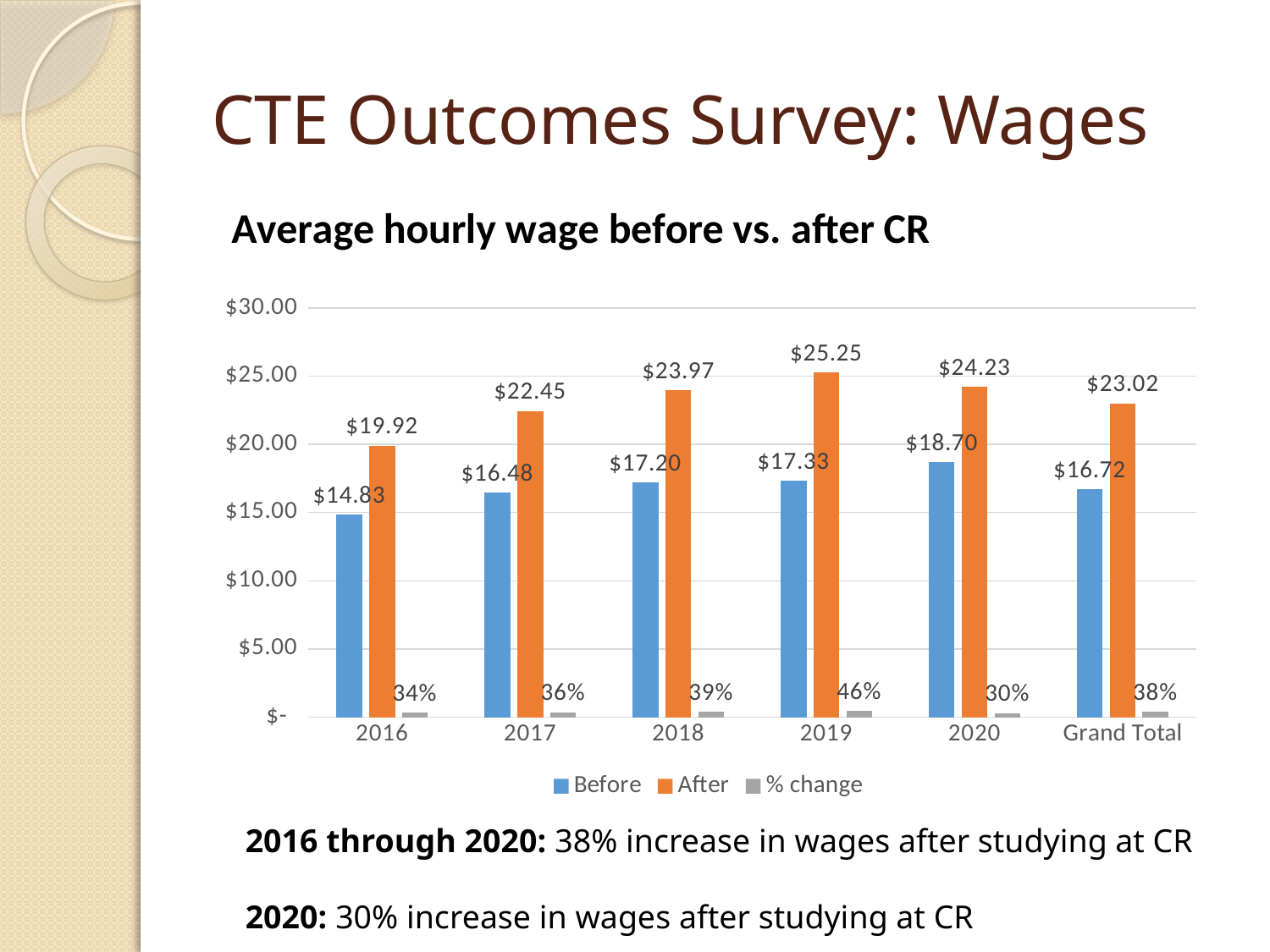
Which category has the lowest 'Before' wage? 2016 What is the 'After' average hourly wage for 2019? $25.25 Is the 'After' wage for 2016 greater or less than $20.00? less What is the 'Before' average hourly wage for 2017? $16.48 How many series does the legend list? 3 Which year has the highest 'After' wage? 2019 Do the 'After' wages rise or fall from 2016 to 2019? rise How many categories are shown on the x axis? 6 What kind of chart is shown? bar chart What is the % change shown for 2020? 30% Which is larger, the 'Before' wage for 2020 or the 'Before' wage for Grand Total? 2020 What is the difference between the 'After' and 'Before' wages for 2018? $6.77